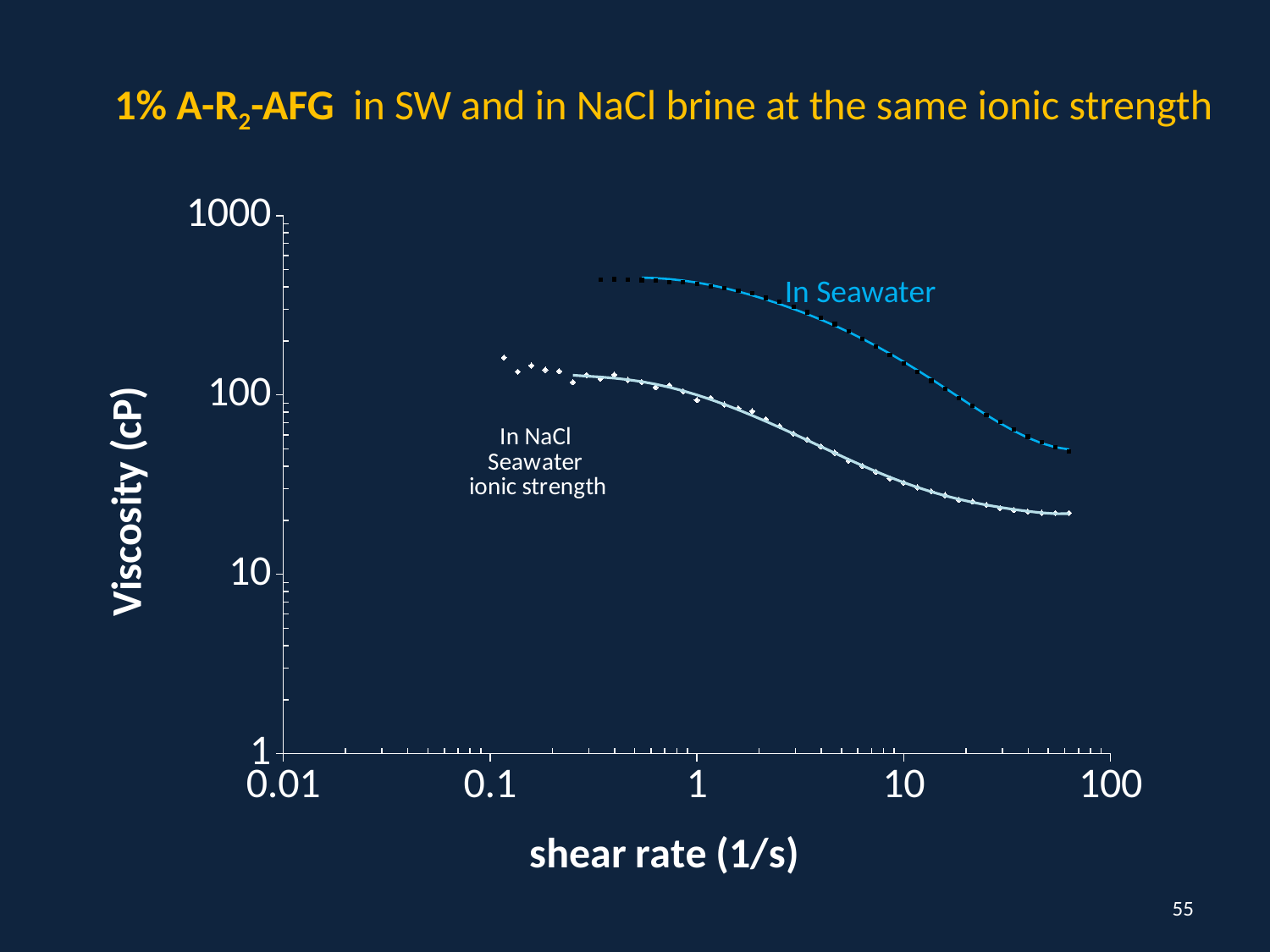
Is the viscosity of the 'In Seawater' series at a shear rate of 10 1/s greater or less than 100 cP? greater Which series has the lower viscosity at a shear rate of 10 1/s? In NaCl Seawater ionic strength What is the label of the x axis? shear rate (1/s) Which series has the higher viscosity at a shear rate of 1 1/s: 'In Seawater' or 'In NaCl Seawater ionic strength'? In Seawater Does the viscosity of the 'In NaCl Seawater ionic strength' series rise or fall as shear rate increases? Fall Is the viscosity of the 'In Seawater' series at a shear rate of 1 1/s greater or less than 100 cP? greater Does the viscosity of the 'In Seawater' series rise or fall as shear rate increases? Fall Is the viscosity of the 'In NaCl Seawater ionic strength' series at a shear rate of 10 1/s greater or less than 10 cP? greater What kind of chart is shown on the slide? Line chart (scatter with fitted curves) What is the label of the y axis? Viscosity (cP) How many data series are plotted on the chart? 2